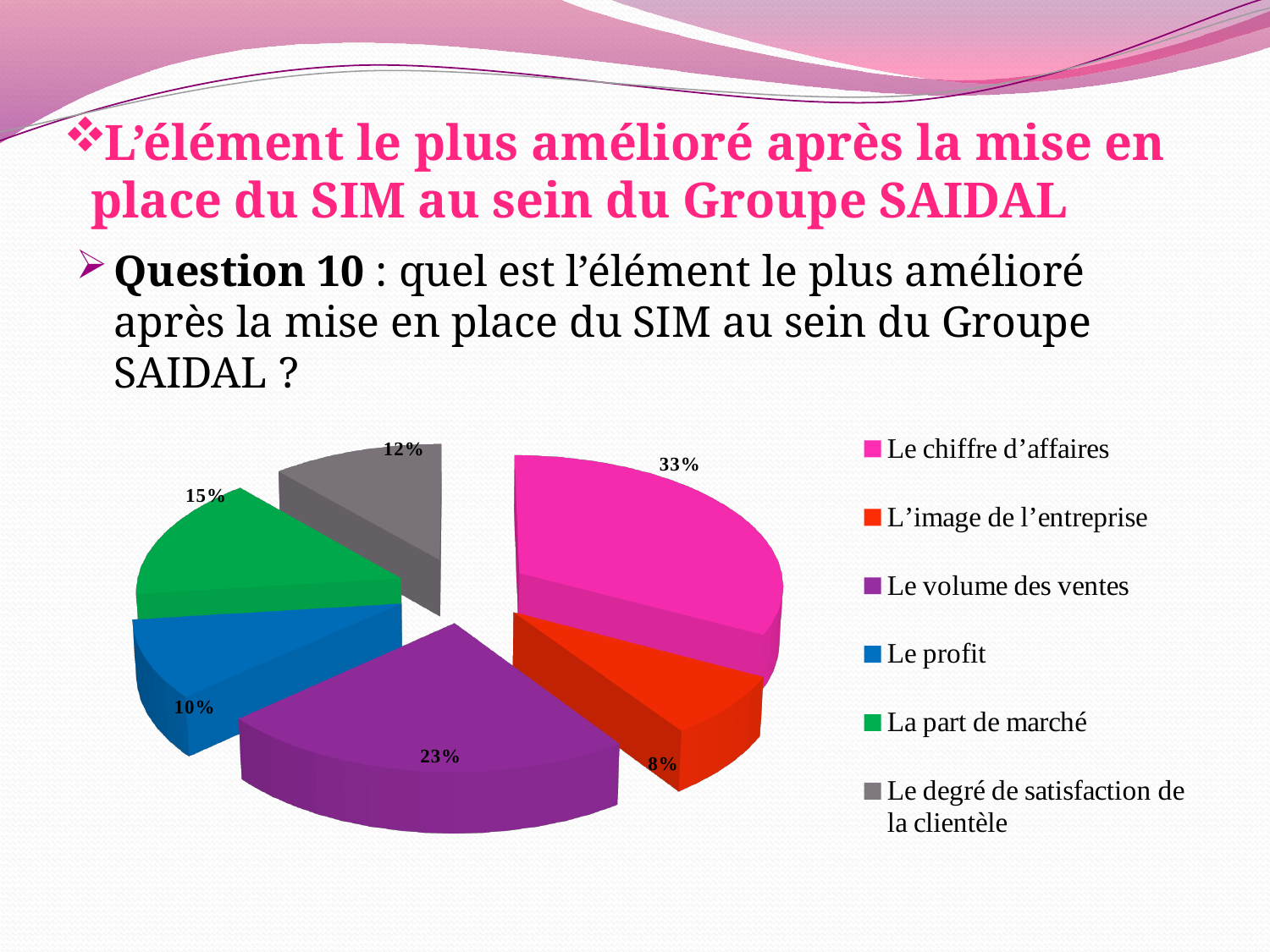
How many slices does the pie chart have? 6 Which is larger: the share for 'La part de marché' or the share for 'Le profit'? La part de marché What percentage of the pie is 'Le degré de satisfaction de la clientèle'? 12% How many entries does the legend list? 6 Which category has the smallest share of the pie? L'image de l'entreprise What percentage of the pie is 'Le volume des ventes'? 23% What is the difference in percentage points between 'Le chiffre d'affaires' and 'Le volume des ventes'? 10 What colour is the slice for 'Le profit'? Blue What percentage of the pie is 'Le chiffre d'affaires'? 33% Which category has the largest share of the pie? Le chiffre d'affaires What kind of chart is shown on the slide? Pie chart What percentage of the pie is 'L'image de l'entreprise'? 8%